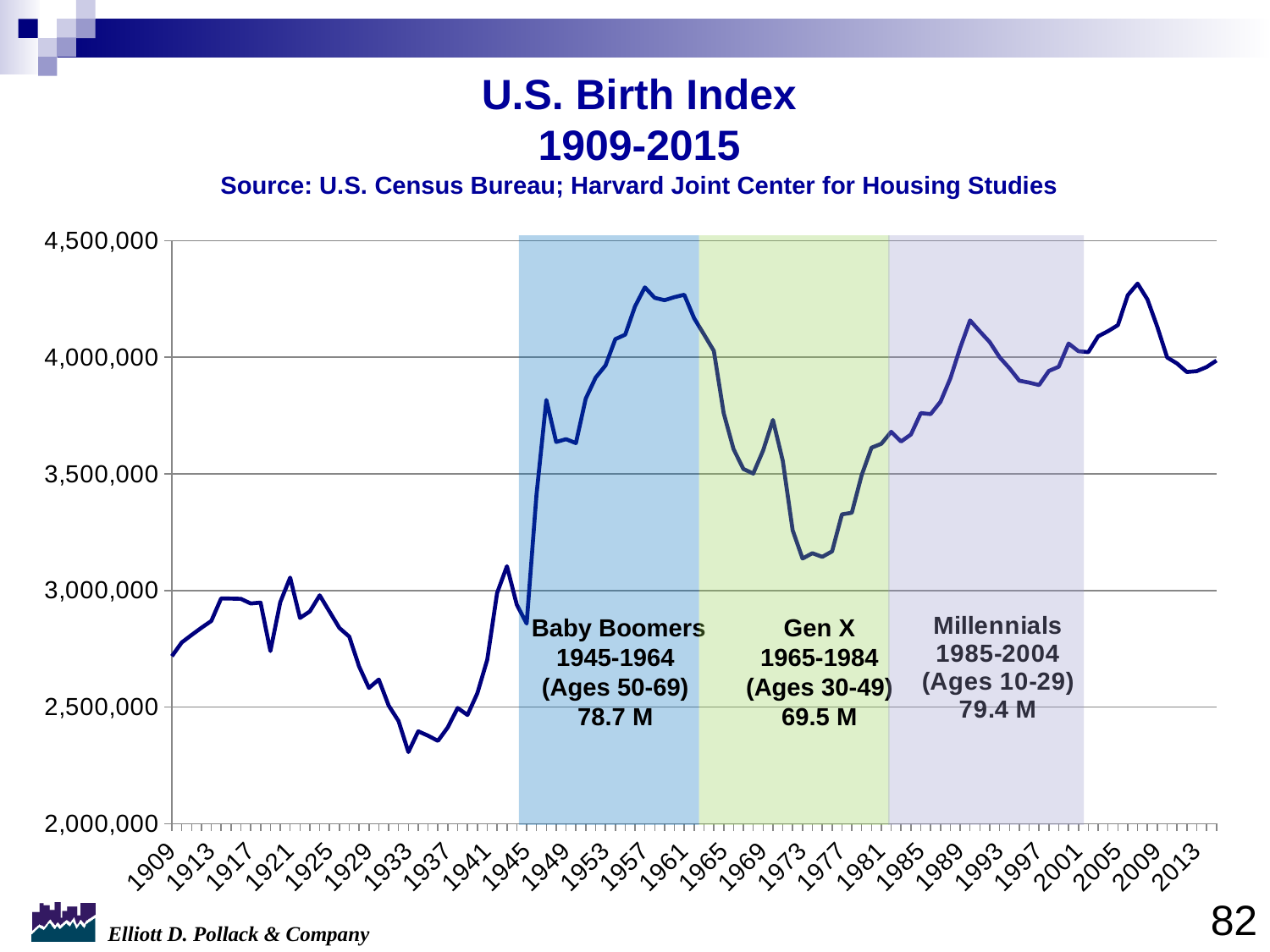
Is the value for 1933 greater or less than 2,500,000? less Which year has the lowest value on the chart? 1933 Which is larger, the value for 1973 or the value for 1990? 1990 Is the value for 2007 greater or less than 4,000,000? greater Is the value for 1909 greater or less than 3,000,000? less Do the values rise or fall from 1973 to 1990? rise Which is larger, the value for 1957 or the value for 1933? 1957 Do the values rise or fall from 1957 to 1973? fall What kind of chart is shown on the slide? line chart What population figure is shown for the Millennials (1985-2004) band on the chart? 79.4 M